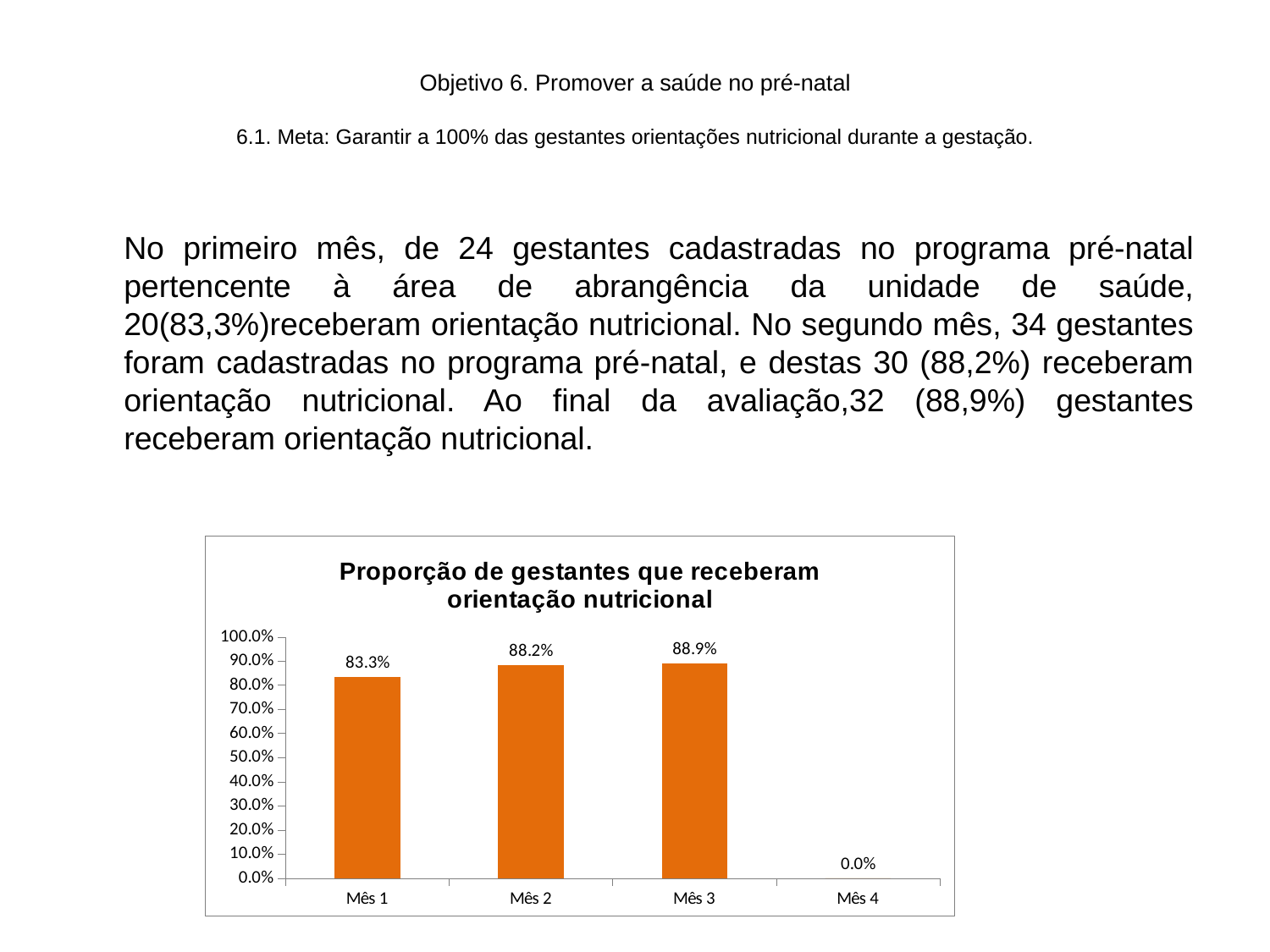
What kind of chart is shown? Bar chart What is the value for Mês 1? 83.3% Is the value for Mês 1 greater or less than 80.0%? greater How many months are shown on the x axis? 4 Which is larger, the value for Mês 1 or the value for Mês 2? Mês 2 What is the difference between the values for Mês 2 and Mês 1? 4.9% What is the value for Mês 2? 88.2% Which month has the highest value? Mês 3 What is the value for Mês 3? 88.9% Which month has the lowest value? Mês 4 What is the title of the chart? Proporção de gestantes que receberam orientação nutricional What is the value for Mês 4? 0.0%